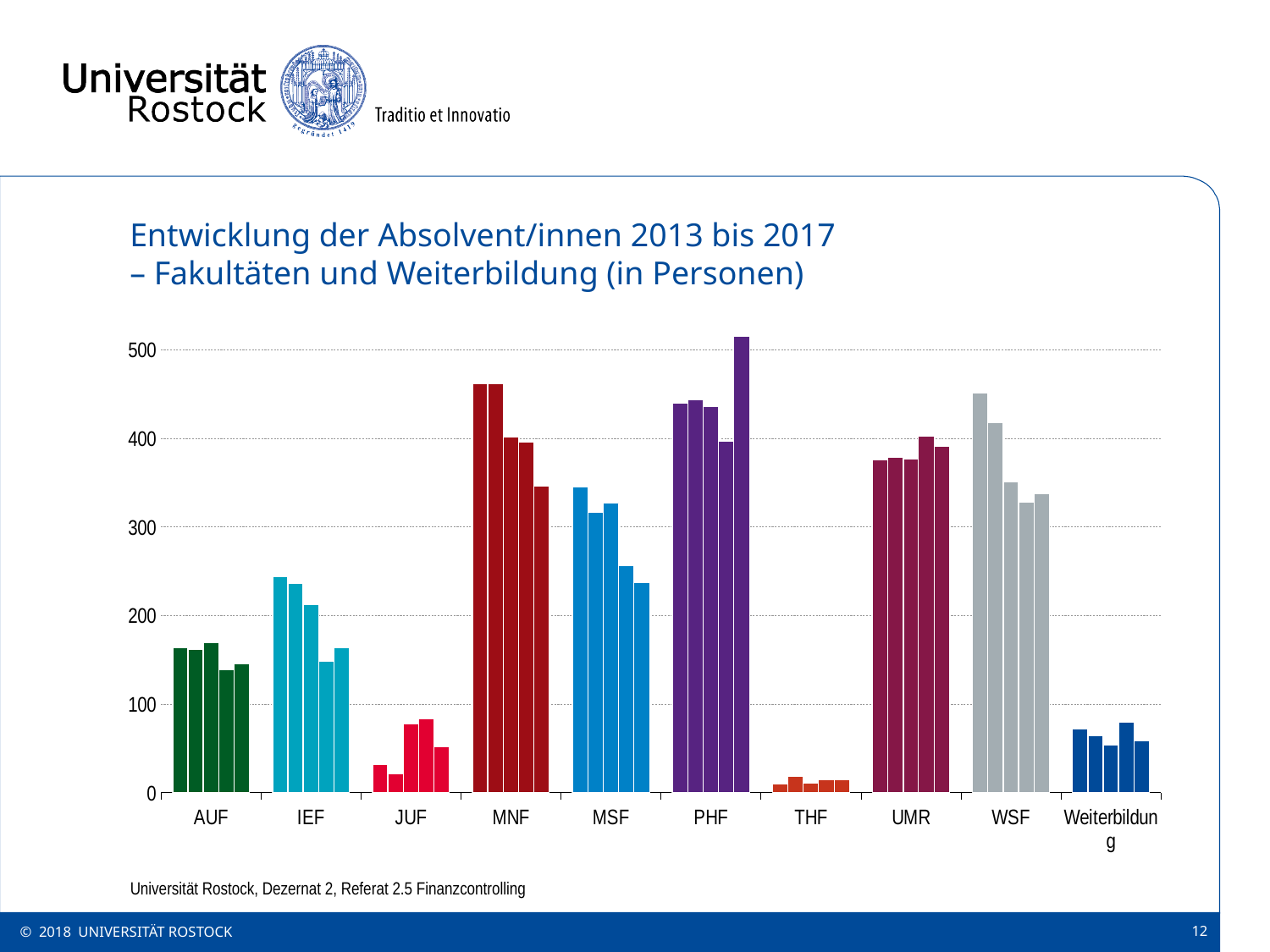
Which is larger, the first bar of MNF or the first bar of MSF? MNF Which category has the lowest bars in the chart? THF How many categories are shown along the x axis of the chart? 10 What is the title of the chart on the slide? Entwicklung der Absolvent/innen 2013 bis 2017 – Fakultäten und Weiterbildung (in Personen) How many bars are plotted for each category in the chart? 5 Is the value of the tallest PHF bar greater or less than 500? greater Is the value of the first MNF bar greater or less than 400? greater Do the MNF bars generally rise or fall from left to right? fall Is the value of the first IEF bar greater or less than 200? greater Which category contains the tallest bar in the chart? PHF What kind of chart is shown on the slide? bar chart